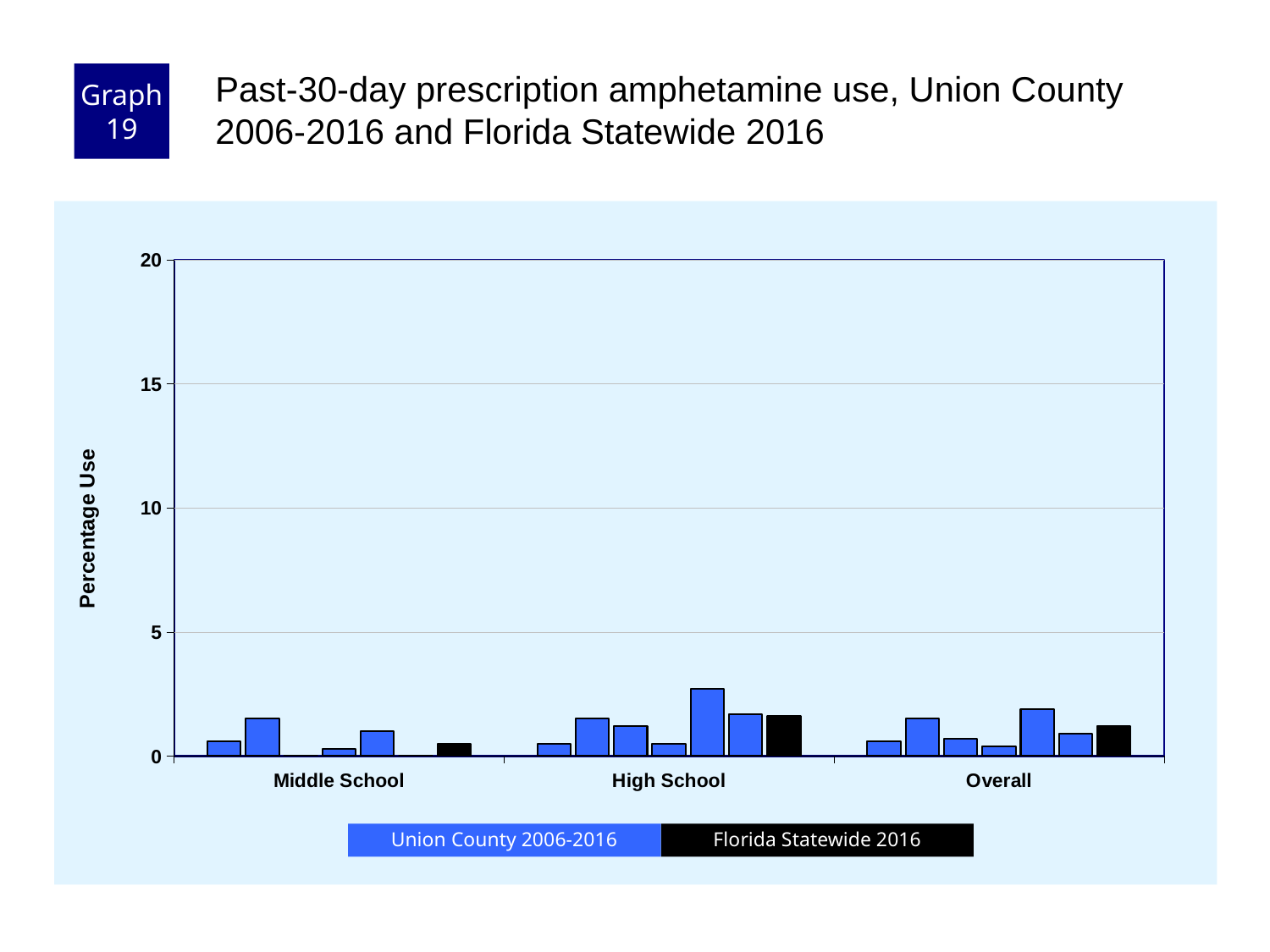
Does the Florida Statewide 2016 value rise or fall from Middle School to High School? rises Is the Florida Statewide 2016 value for Overall greater or less than 5? less Which category group has the highest Florida Statewide 2016 value? High School Which category group has the lowest Florida Statewide 2016 value? Middle School How many series does the legend list? 2 Which is larger: the Florida Statewide 2016 value for High School or for Middle School? High School How many category groups are shown on the x axis? 3 Which colour represents Florida Statewide 2016 in the legend? black What is the label of the y axis? Percentage Use Is the Florida Statewide 2016 value for High School greater or less than 5? less Which category group contains the tallest bar in the chart? High School What kind of chart is shown on the slide? bar chart